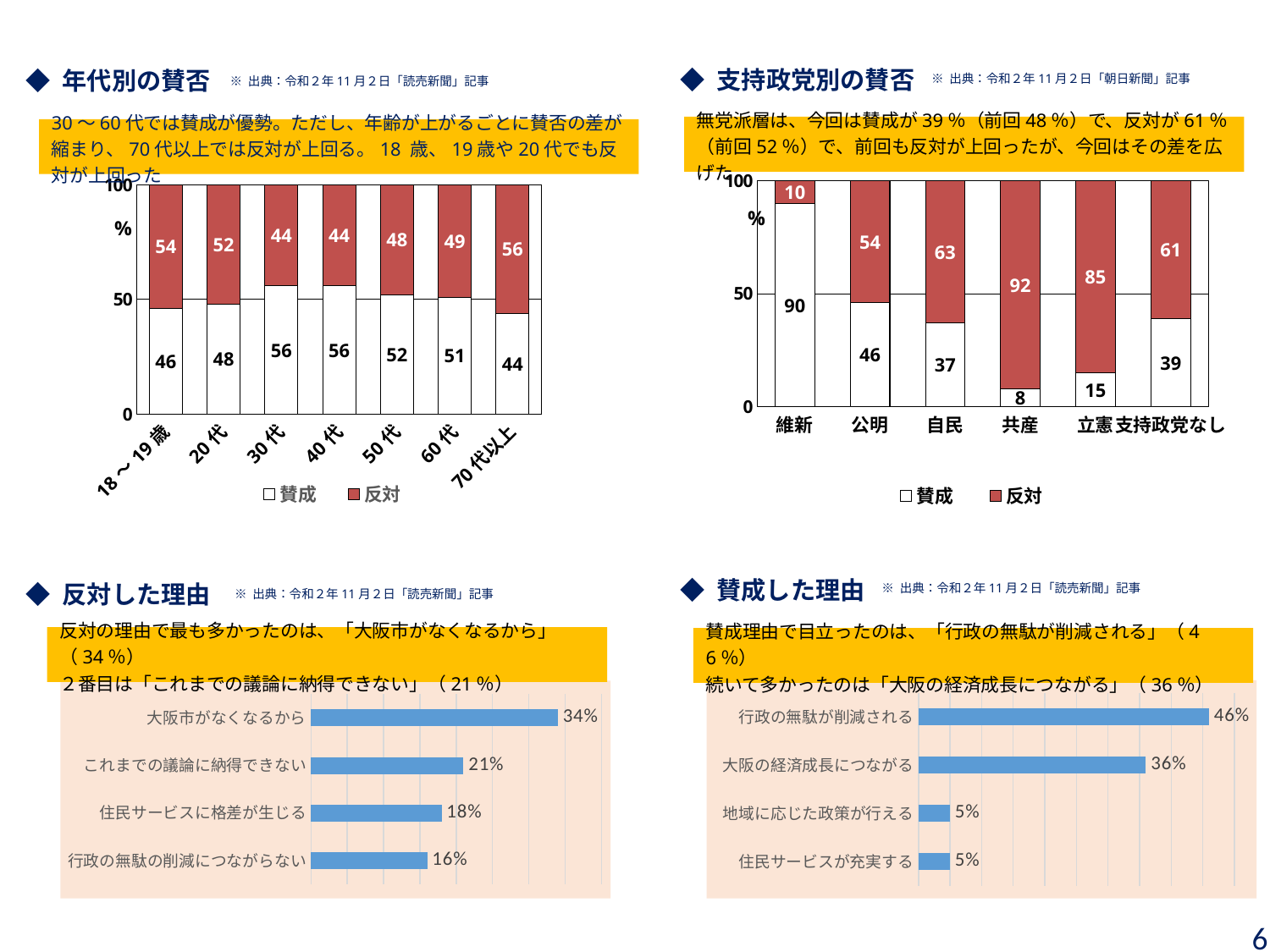
In the 反対した理由 chart, what is the difference between 大阪市がなくなるから and これまでの議論に納得できない? 13% What kind of chart is the 賛成した理由 chart? Bar chart In the 支持政党別の賛否 chart, which party has the lowest 賛成 value? 共産 In the 年代別の賛否 chart, which age group has the highest 反対 value? 70代以上 In the 支持政党別の賛否 chart, what is the 賛成 value for 維新? 90 In the 年代別の賛否 chart, what is the 賛成 value for 30代? 56 In the 支持政党別の賛否 chart, how many series does the legend list? 2 In the 反対した理由 chart, what is the value for 住民サービスに格差が生じる? 18% In the 支持政党別の賛否 chart, is the 反対 value for 自民 larger than the 反対 value for 公明? Yes In the 年代別の賛否 chart, what is the difference between the 反対 and 賛成 values for 18～19歳? 8 In the 年代別の賛否 chart, how many age-group categories are shown? 7 In the 賛成した理由 chart, which reason has the highest value? 行政の無駄が削減される